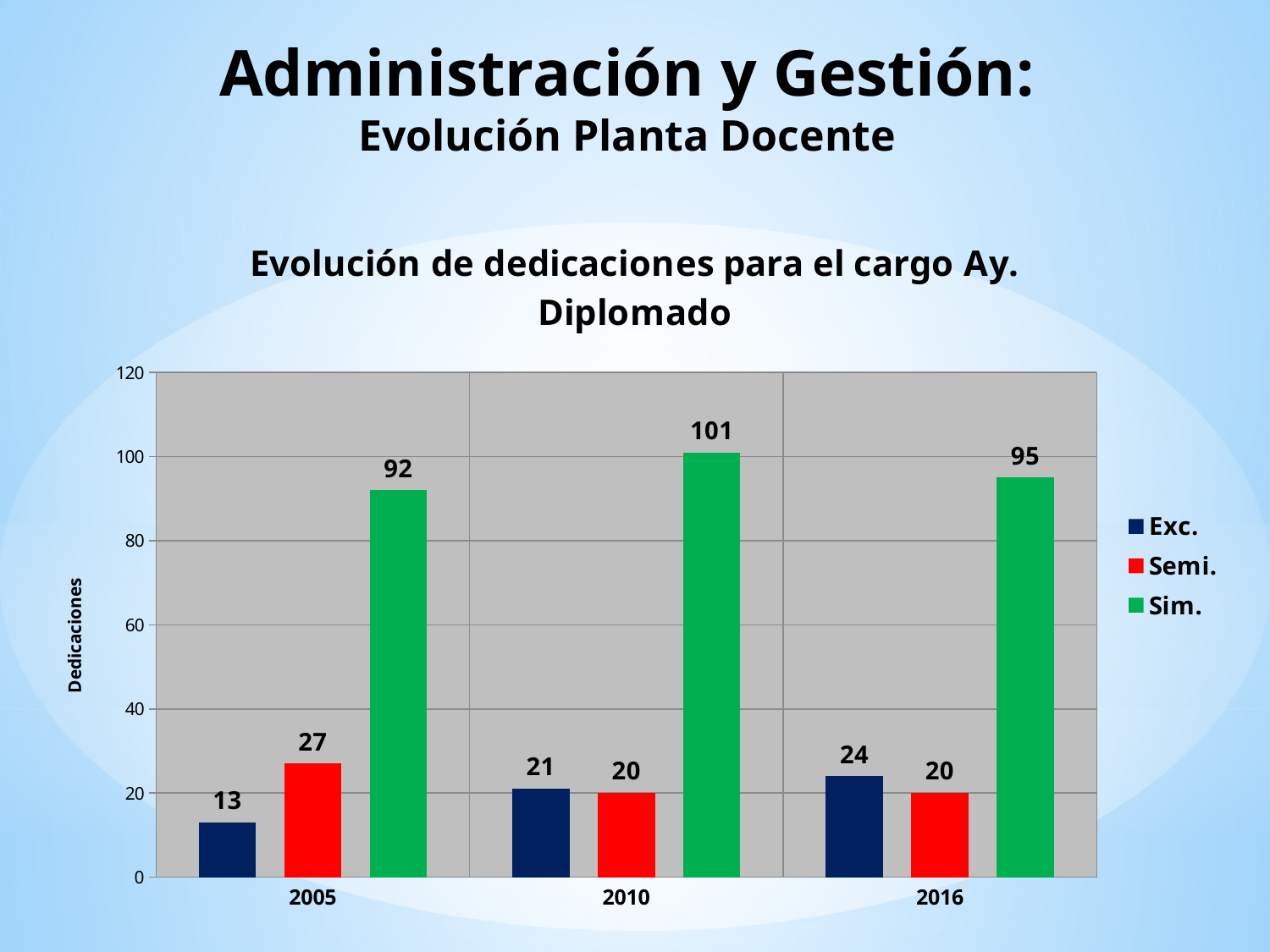
What kind of chart is shown? bar chart What is the value for Sim. in 2010? 101 How many years are shown on the x axis? 3 What is the value for Semi. in 2016? 20 In which year is the Sim. value highest? 2010 In which year is the Exc. value lowest? 2005 Does the Exc. value rise or fall from 2005 to 2016? rise What is the label of the vertical axis? Dedicaciones How many series does the legend list? 3 What is the difference between the Sim. values for 2010 and 2016? 6 What is the value for Exc. in 2005? 13 Which is larger in 2005, Exc. or Semi.? Semi.